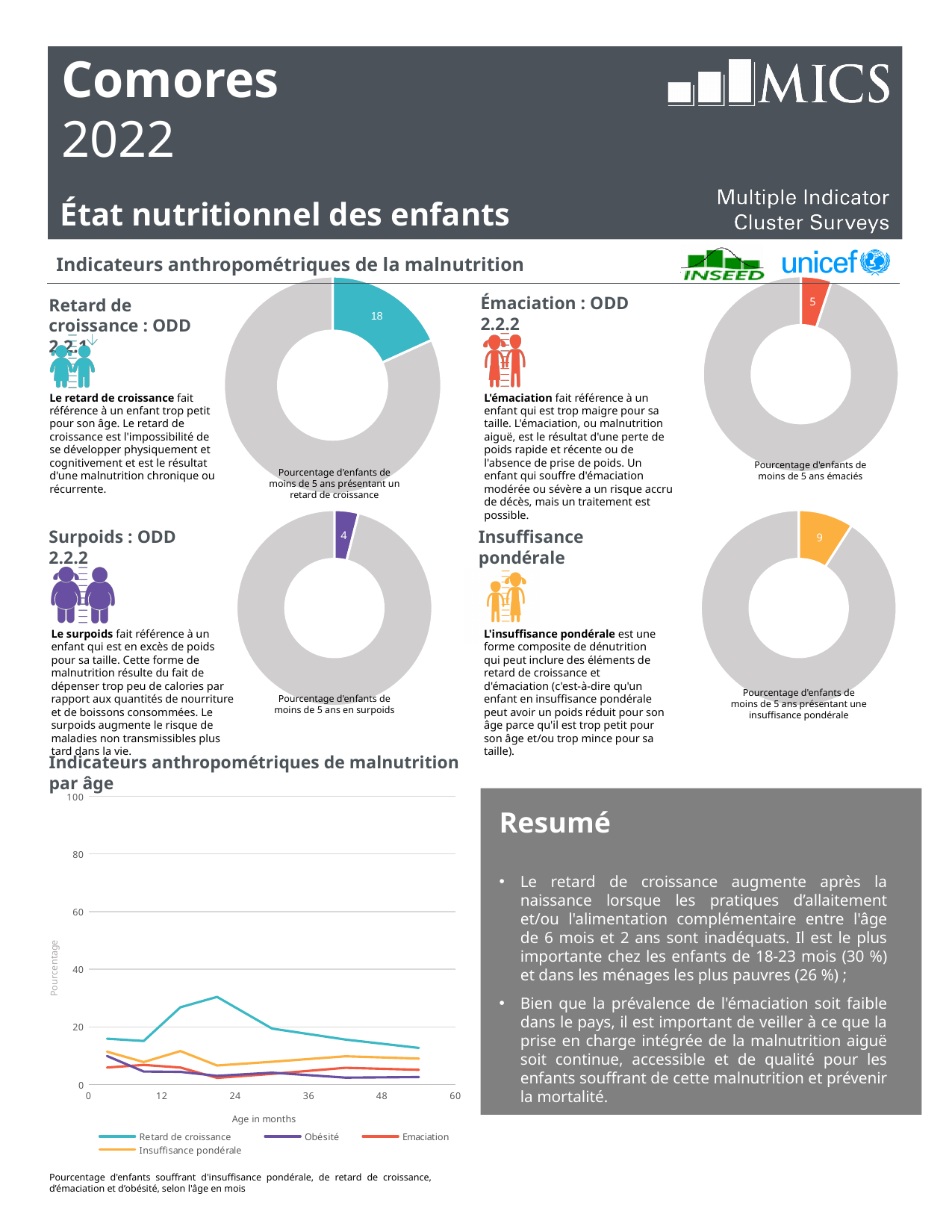
On the 'Indicateurs anthropométriques de malnutrition par âge' chart, which series has the highest values across the age range? Retard de croissance Among the four donut charts, which indicator has the lowest value? Surpoids On the 'Retard de croissance' donut chart, what percentage of children under 5 are stunted? 18 What kind of chart is 'Indicateurs anthropométriques de malnutrition par âge'? line chart On the 'Surpoids' donut chart, what percentage of children under 5 are overweight? 4 On the 'Indicateurs anthropométriques de malnutrition par âge' chart, is the peak value of 'Retard de croissance' greater or less than 40? less On the 'Insuffisance pondérale' donut chart, what percentage of children under 5 are underweight? 9 On the 'Émaciation' donut chart, what percentage of children under 5 are wasted? 5 What is the difference between the value on the 'Retard de croissance' donut chart and the value on the 'Insuffisance pondérale' donut chart? 9 Among the four donut charts, which indicator has the highest value? Retard de croissance Which is larger: the value on the 'Émaciation' donut chart or the value on the 'Surpoids' donut chart? Émaciation How many series does the legend of the 'Indicateurs anthropométriques de malnutrition par âge' chart list? 4